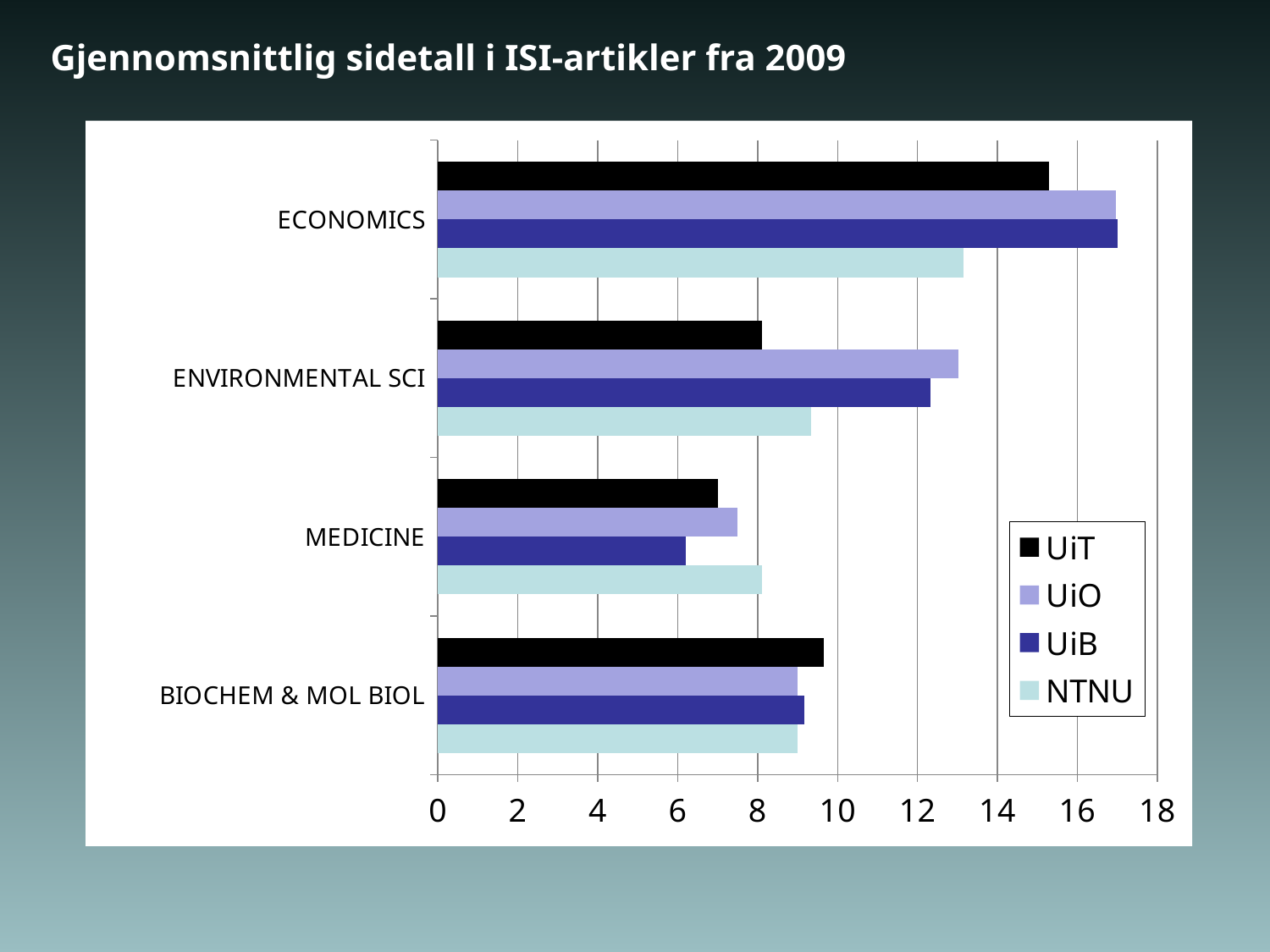
Which series is shown in black in the legend? UiT What is the title of the chart? Gjennomsnittlig sidetall i ISI-artikler fra 2009 Is the UiT value for ECONOMICS greater or less than 14? greater In ENVIRONMENTAL SCI, which is larger: the UiO value or the UiT value? UiO In MEDICINE, which is larger: the NTNU value or the UiB value? NTNU Is the UiB value for MEDICINE greater or less than 8? less For which category is the UiT value lowest? MEDICINE How many series does the legend list? 4 How many categories are shown on the chart? 4 For which category is the NTNU value highest? ECONOMICS What kind of chart is shown on the slide? bar chart For which category is the UiT value highest? ECONOMICS